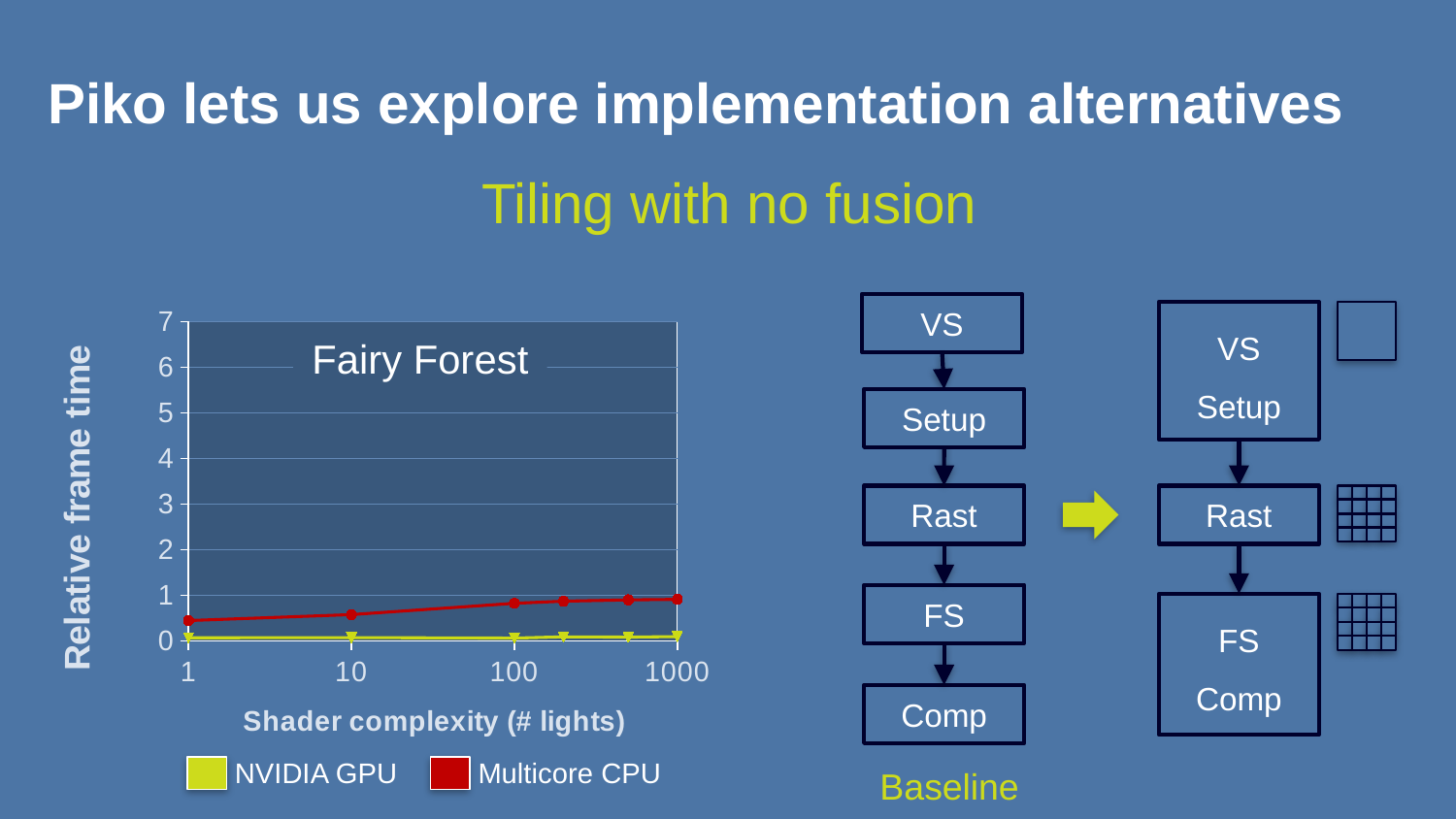
Is the Multicore CPU relative frame time at 1 light greater or less than 1? less How many tick labels are shown on the x axis of the chart? 4 What is the label of the x axis of the chart? Shader complexity (# lights) How many series does the chart legend list? 2 Is the Multicore CPU relative frame time at 1000 lights greater or less than 0? greater Is the NVIDIA GPU relative frame time at 100 lights greater or less than 1? less Does the Multicore CPU relative frame time rise or fall as shader complexity increases from 1 to 1000 lights? rise What is the title shown inside the chart? Fairy Forest Which series has the higher relative frame time at 1000 lights, NVIDIA GPU or Multicore CPU? Multicore CPU What kind of chart is shown on the slide? line chart Which series has the lower relative frame time across the chart? NVIDIA GPU